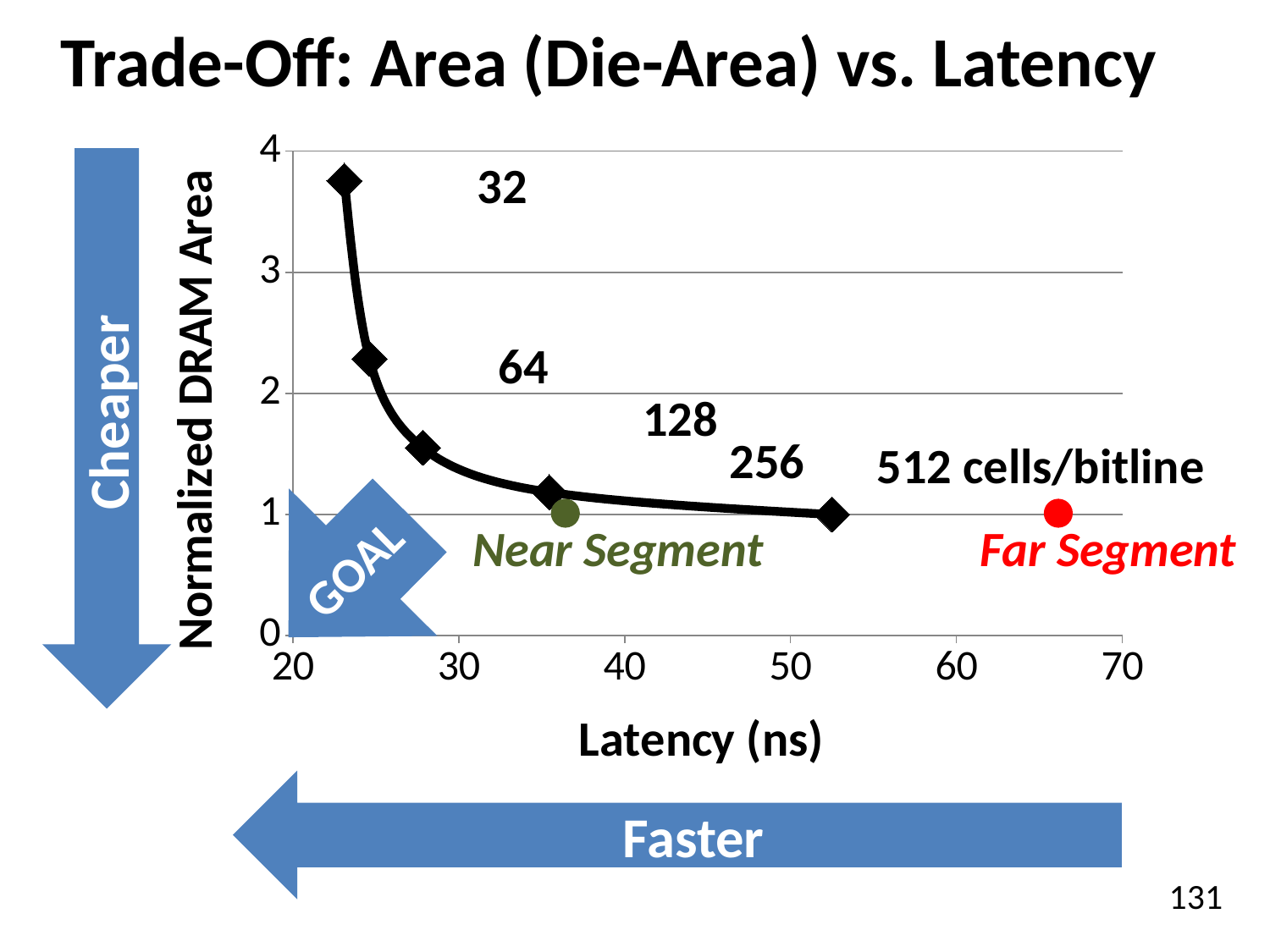
Is the normalized DRAM area for 64 cells/bitline greater or less than 2? greater As latency increases along the x axis, does the normalized DRAM area rise or fall? fall Which cells/bitline configuration has the highest normalized DRAM area? 32 What kind of chart is shown on the slide? line chart Which cells/bitline configuration has the lowest normalized DRAM area? 512 Is the latency for 256 cells/bitline greater or less than 50 ns? less Is the normalized DRAM area for 32 cells/bitline greater or less than 3? greater How many cells/bitline data points (black diamonds) are plotted on the curve? 5 What is the normalized DRAM area for 512 cells/bitline? 1 What is the label of the x axis? Latency (ns) Which has the higher normalized DRAM area, 64 cells/bitline or 128 cells/bitline? 64 cells/bitline What is the label of the y axis? Normalized DRAM Area